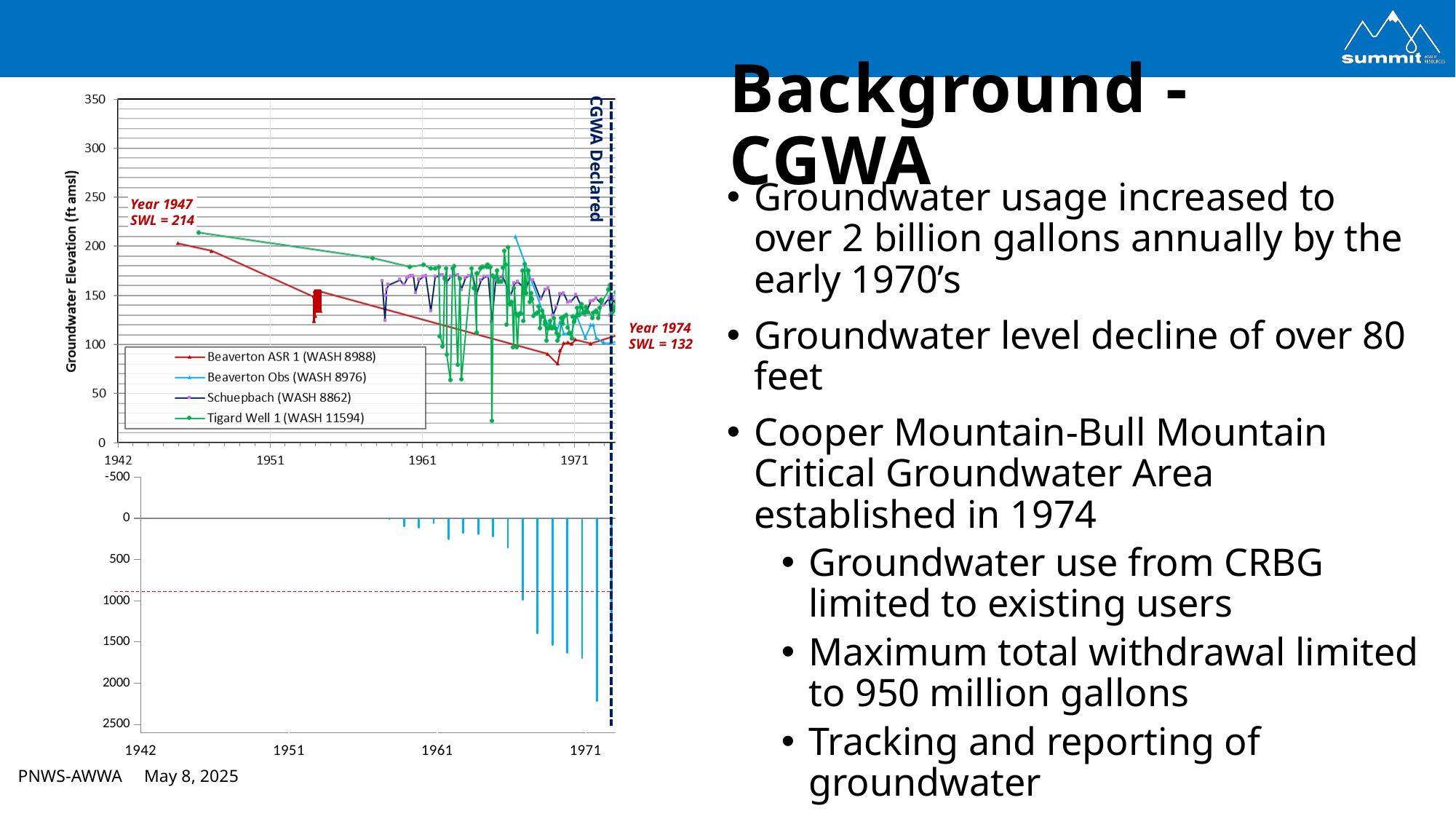
In the top chart, what SWL value is annotated for Year 1974? 132 What kind of chart is the top chart on the slide? line chart In the bottom chart, is the longest bar greater or less than 2000? greater In the bottom chart, do the bar lengths increase or decrease from 1961 to 1971? increase In the top chart, what is the difference between the annotated SWL for Year 1947 and the annotated SWL for Year 1974? 82 What kind of chart is the bottom chart on the slide? bar chart In the top chart, does the Beaverton ASR 1 (WASH 8988) series rise or fall from 1945 to 1970? fall In the top chart, what does the vertical dashed line near 1974 mark? CGWA Declared In the top chart, how many series does the legend list? 4 In the top chart, what SWL value is annotated for Year 1947? 214 In the top chart, what is the label of the y axis? Groundwater Elevation (ft amsl) In the top chart, which annotated SWL is larger, Year 1947 or Year 1974? Year 1947